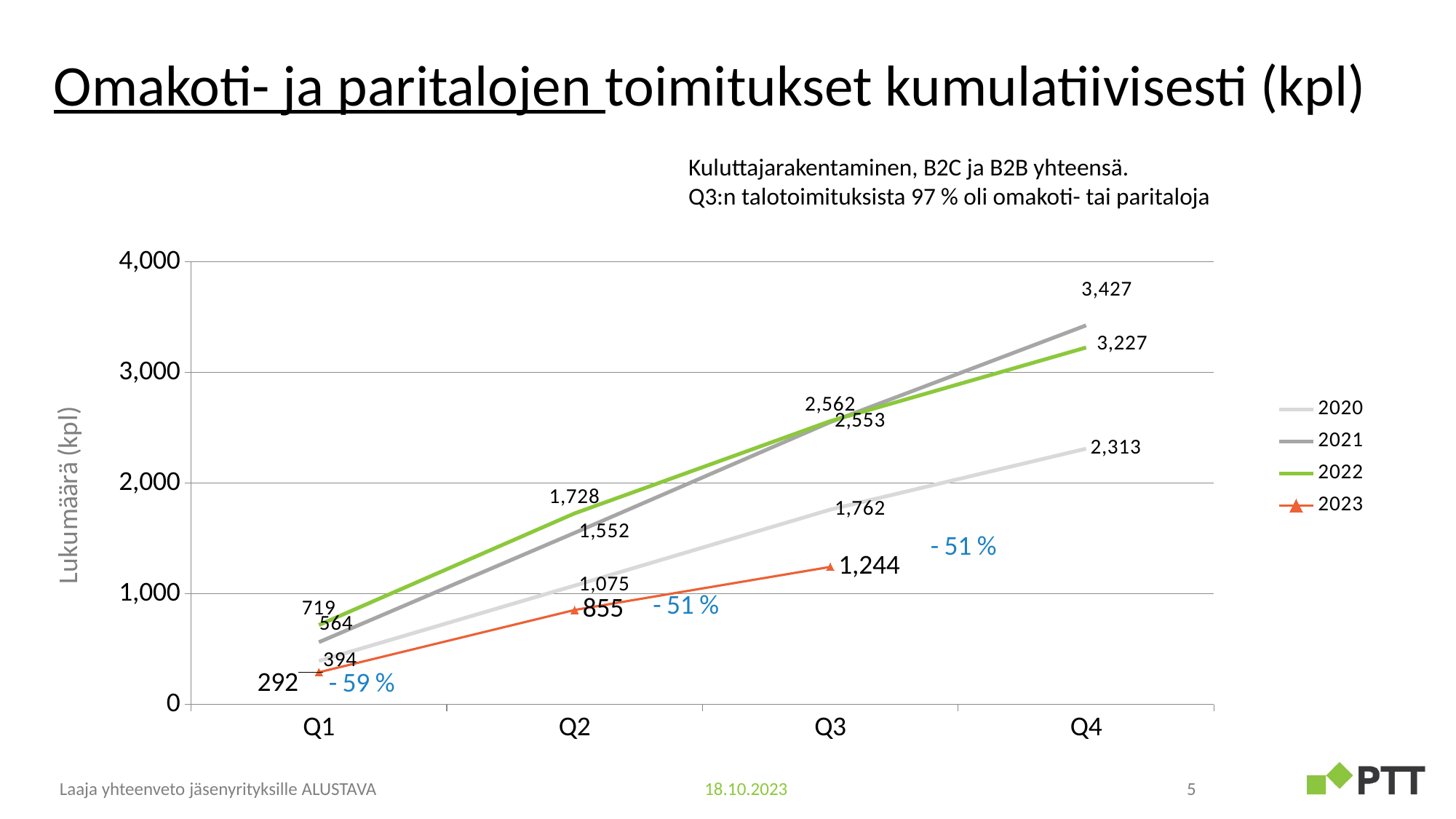
Which series has the highest value at Q4? 2021 What kind of chart is shown on the slide? line chart What is the value for 2023 at Q3? 1,244 Do the values for 2022 rise or fall from Q1 to Q4? rise Which series has the lowest value at Q1? 2023 What is the value for 2021 at Q4? 3,427 Which is larger at Q2: the value for 2020 or the value for 2023? 2020 Is the value for 2020 at Q4 greater or less than 2,000? greater What is the difference between the 2020 and 2023 values at Q1? 102 What is the difference between the 2021 and 2022 values at Q4? 200 How many series does the legend list? 4 What is the value for 2022 at Q1? 719